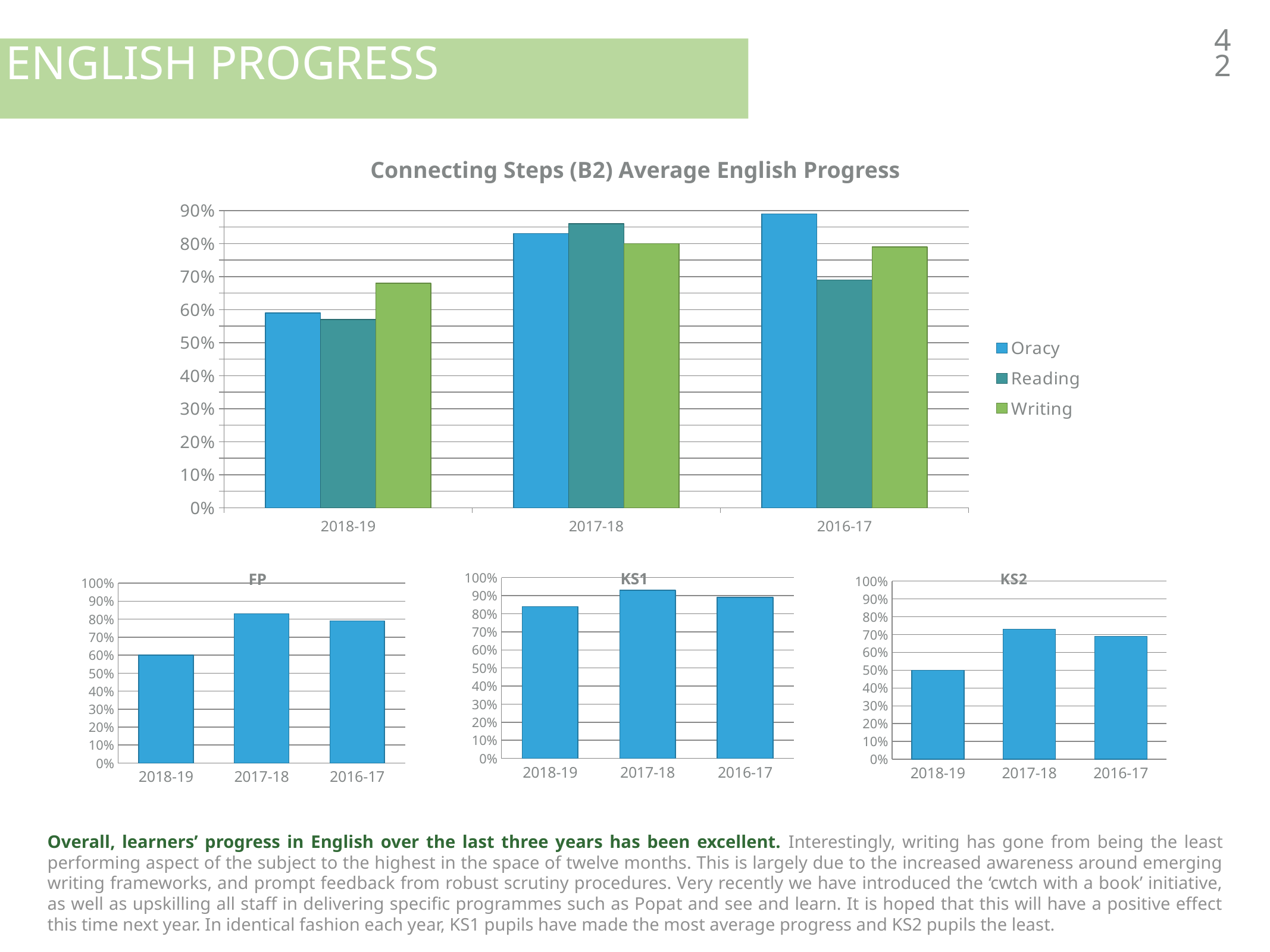
In the 'Connecting Steps (B2) Average English Progress' chart, is the Reading value for 2018-19 greater or less than 60%? less In the 'Connecting Steps (B2) Average English Progress' chart, what colour represents the Writing series in the legend? green How many year categories are shown on the x axis of the 'Connecting Steps (B2) Average English Progress' chart? 3 In the 'Connecting Steps (B2) Average English Progress' chart, which series has the highest value for 2016-17? Oracy What kind of chart is the 'Connecting Steps (B2) Average English Progress' chart? bar chart In the KS2 chart, is the value for 2017-18 greater or less than 70%? greater In the 'Connecting Steps (B2) Average English Progress' chart, is the Oracy value for 2016-17 greater or less than 80%? greater How many series does the legend of the 'Connecting Steps (B2) Average English Progress' chart list? 3 In the KS1 chart, which year has the highest bar? 2017-18 In the KS2 chart, which year has the lowest bar? 2018-19 In the 'Connecting Steps (B2) Average English Progress' chart, which is larger for 2017-18: Reading or Writing? Reading In the 'Connecting Steps (B2) Average English Progress' chart, which series has the highest value for 2018-19? Writing